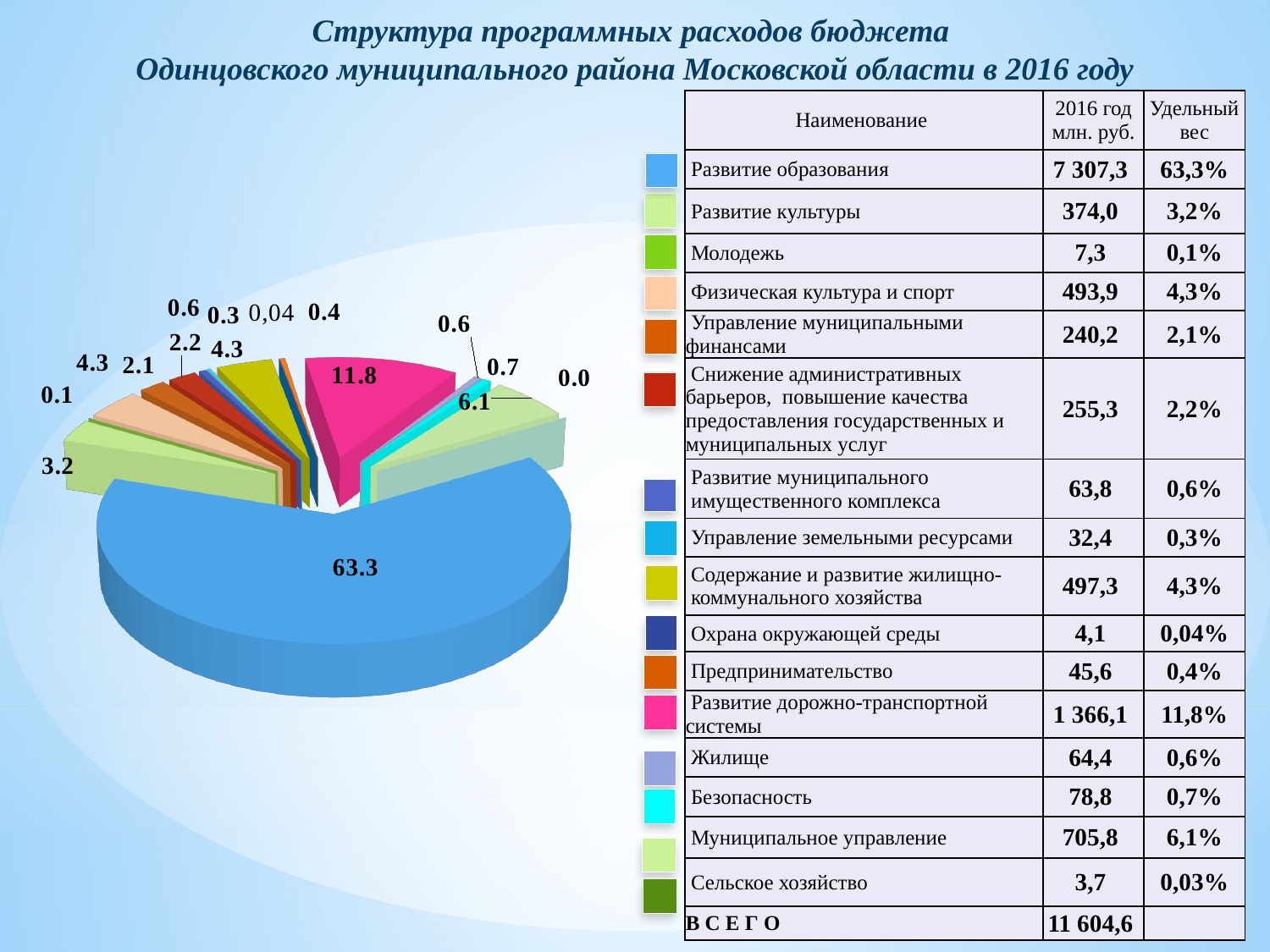
What data label is shown on the slice for Муниципальное управление? 6.1 What is the difference between the data labels for Развитие образования (63.3) and Развитие дорожно-транспортной системы (11.8)? 51.5 What is the title of the chart on the slide? Структура программных расходов бюджета Одинцовского муниципального района Московской области в 2016 году What data label is shown on the pink slice for Развитие дорожно-транспортной системы? 11.8 Which is larger: the slice for Развитие образования or the slice for Развитие дорожно-транспортной системы? Развитие образования How many categories (slices) does the pie chart represent, according to the table? 16 What data label is shown on the largest slice of the pie chart? 63.3 What share of the pie does Физическая культура и спорт have, according to the table? 4,3% What kind of chart is shown on the slide? pie chart Which category has the largest slice in the pie chart? Развитие образования Which category has the smallest share in the pie chart? Сельское хозяйство What data label is shown on the slice for Развитие культуры? 3.2